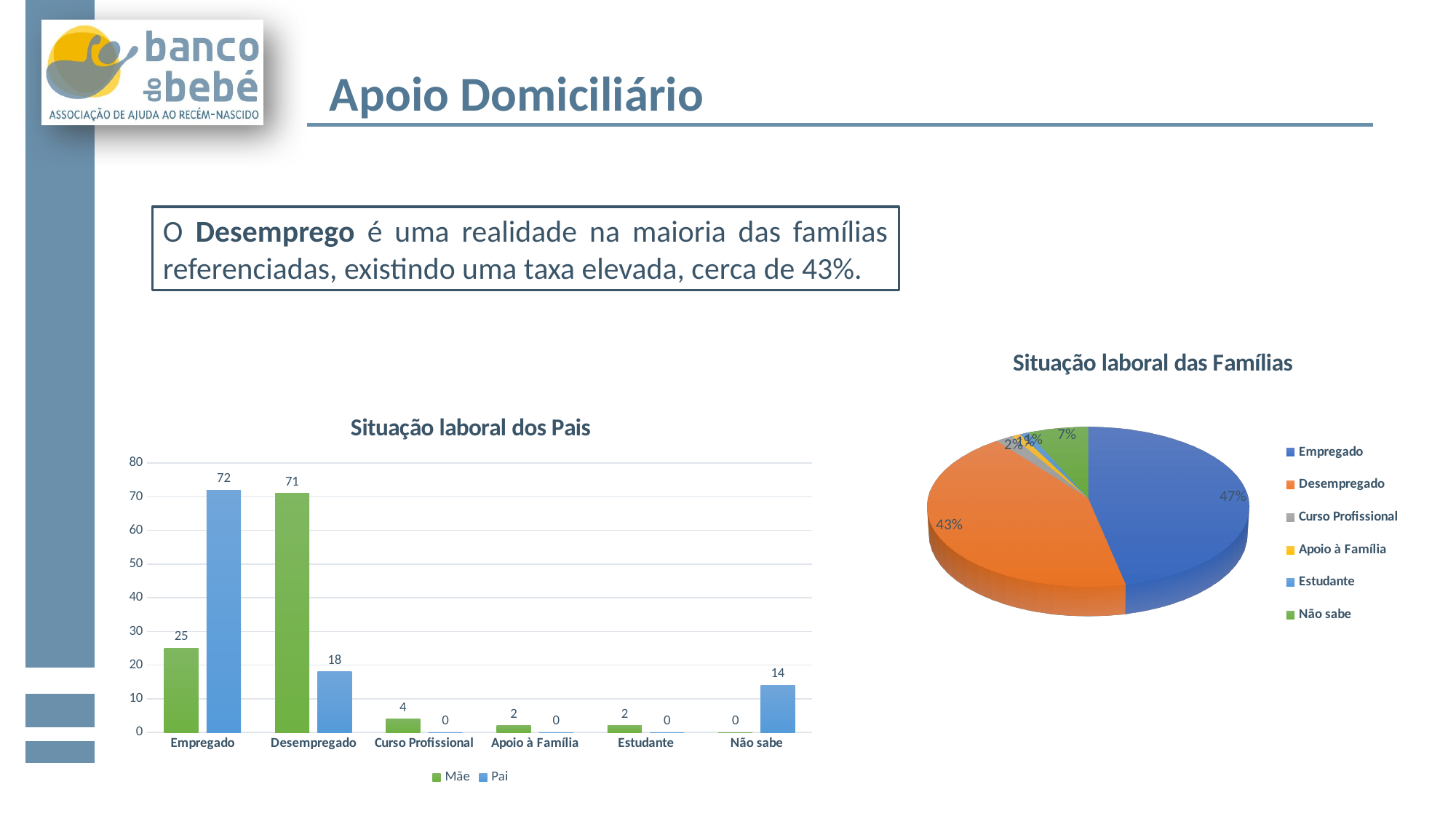
In the 'Situação laboral das Famílias' pie chart, what share does Desempregado have? 43% In the 'Situação laboral dos Pais' chart, what is the difference between the Mãe and Pai values for Desempregado? 53 What kind of chart is 'Situação laboral das Famílias'? Pie chart In the 'Situação laboral das Famílias' pie chart, which slice is the largest? Empregado In the 'Situação laboral dos Pais' chart, what is the value for Mãe in the Desempregado category? 71 In the 'Situação laboral dos Pais' chart, what is the value for Pai in the Empregado category? 72 How many categories are shown on the x axis of the 'Situação laboral dos Pais' chart? 6 How many series does the legend of the 'Situação laboral dos Pais' chart list? 2 In the 'Situação laboral dos Pais' chart, which is larger for Empregado: Mãe or Pai? Pai What kind of chart is 'Situação laboral dos Pais'? Bar chart In the 'Situação laboral dos Pais' chart, which category has the highest value for Mãe? Desempregado In the 'Situação laboral dos Pais' chart, what is the value for Pai in the Não sabe category? 14